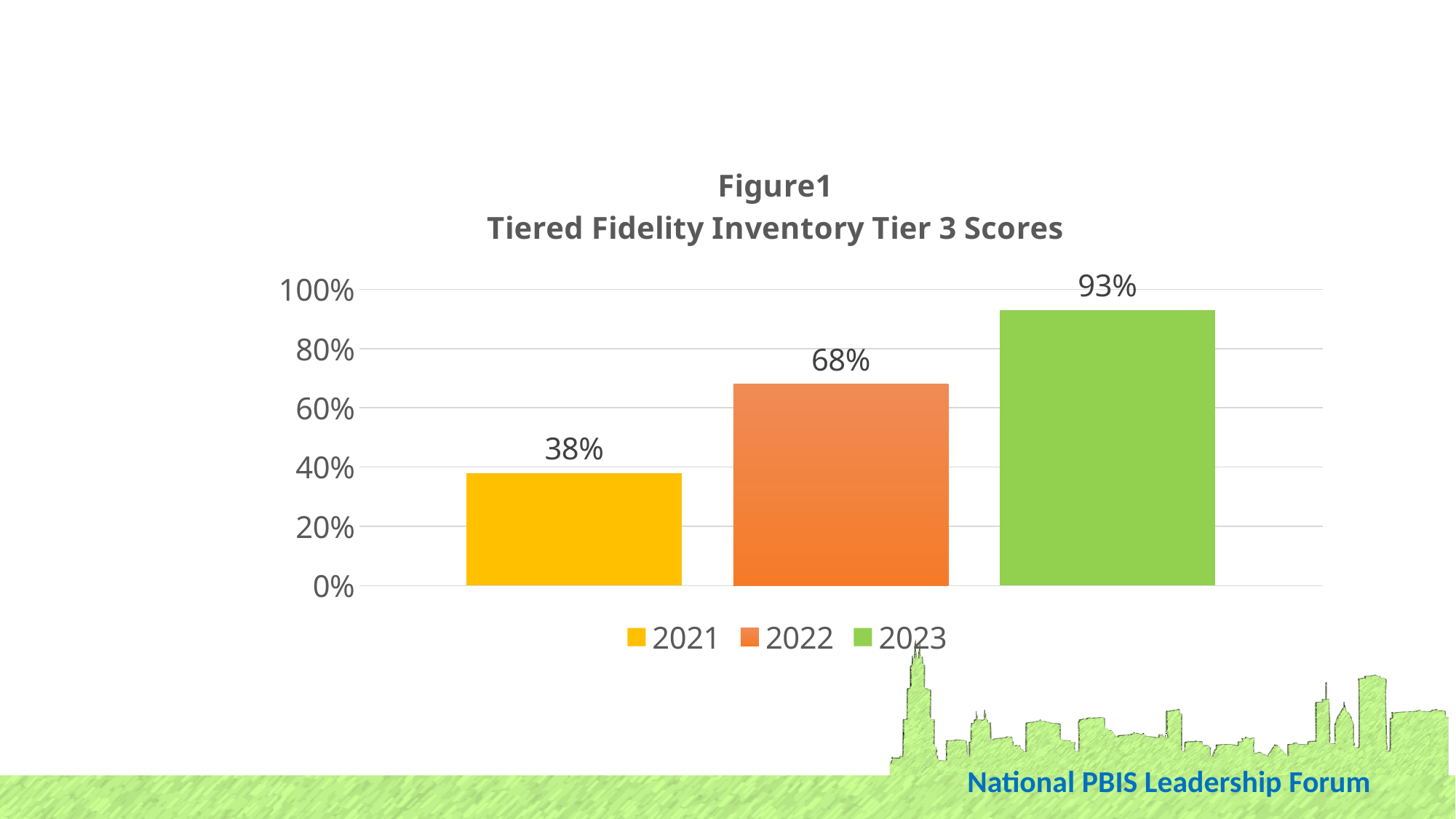
Which year has the lowest Tier 3 score? 2021 What is the Tier 3 score for 2023? 93% What is the Tier 3 score for 2021? 38% What kind of chart is shown on the slide? Bar chart Do the scores rise or fall from 2021 to 2023? Rise What is the difference between the 2022 and 2021 scores? 30% Which year has the highest Tier 3 score? 2023 Which is larger, the score for 2022 or the score for 2021? 2022 Is the value for 2022 greater or less than 60%? greater What is the difference between the 2023 and 2021 scores? 55% How many bars are shown in the chart? 3 What is the Tier 3 score for 2022? 68%